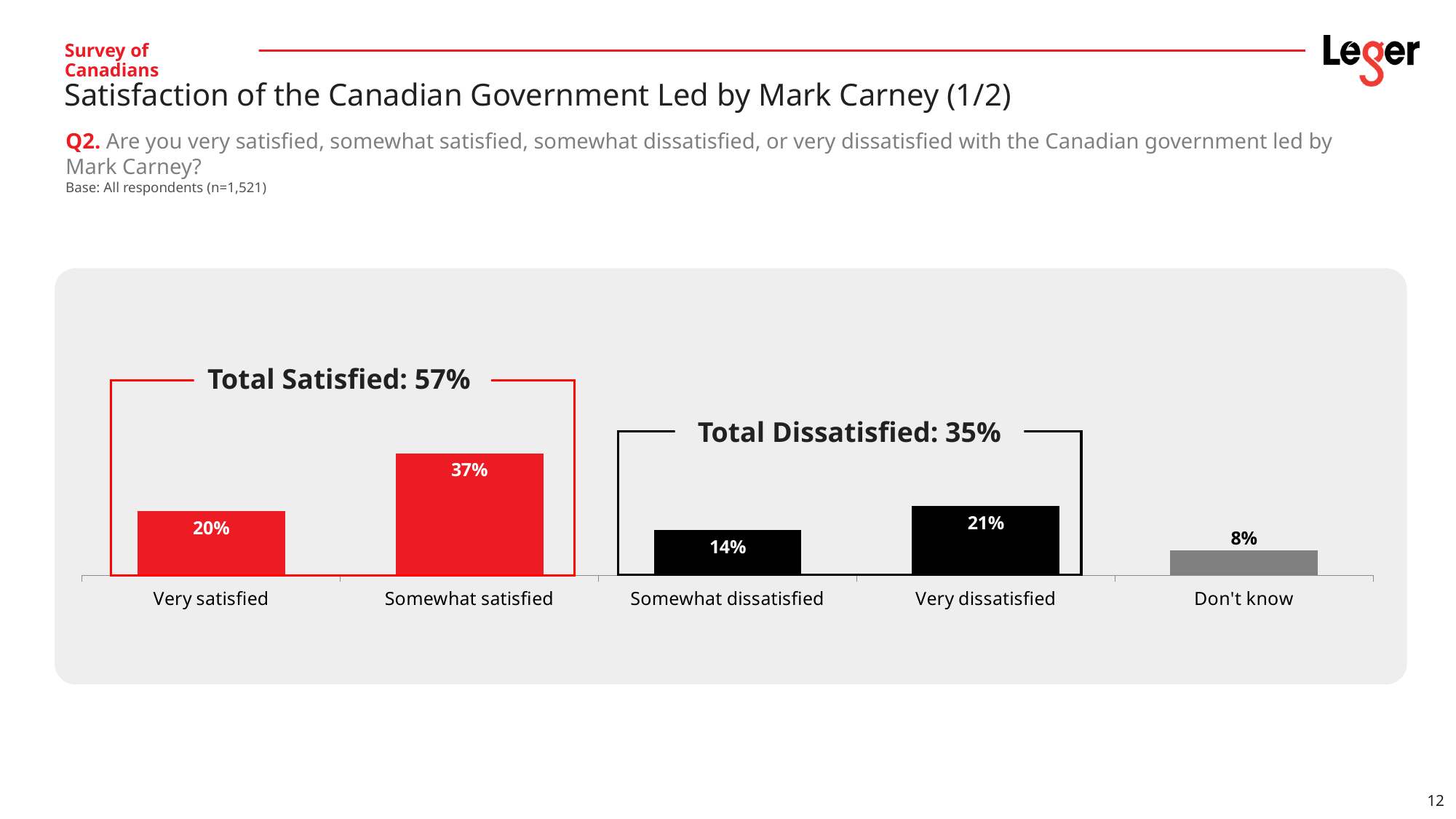
What is the Total Dissatisfied percentage shown on the chart? 35% What percentage of respondents are very satisfied with the Canadian government led by Mark Carney? 20% Which response category has the highest percentage? Somewhat satisfied What percentage of respondents are somewhat dissatisfied? 14% What is the difference between the percentage somewhat satisfied and the percentage very satisfied? 17% What percentage of respondents answered 'Don't know'? 8% What percentage of respondents are somewhat satisfied? 37% What kind of chart is shown on the slide? Bar chart How many response categories are shown in the chart? 5 Which is larger: the percentage very dissatisfied or the percentage somewhat dissatisfied? Very dissatisfied Which response category has the lowest percentage? Don't know What is the Total Satisfied percentage shown on the chart? 57%